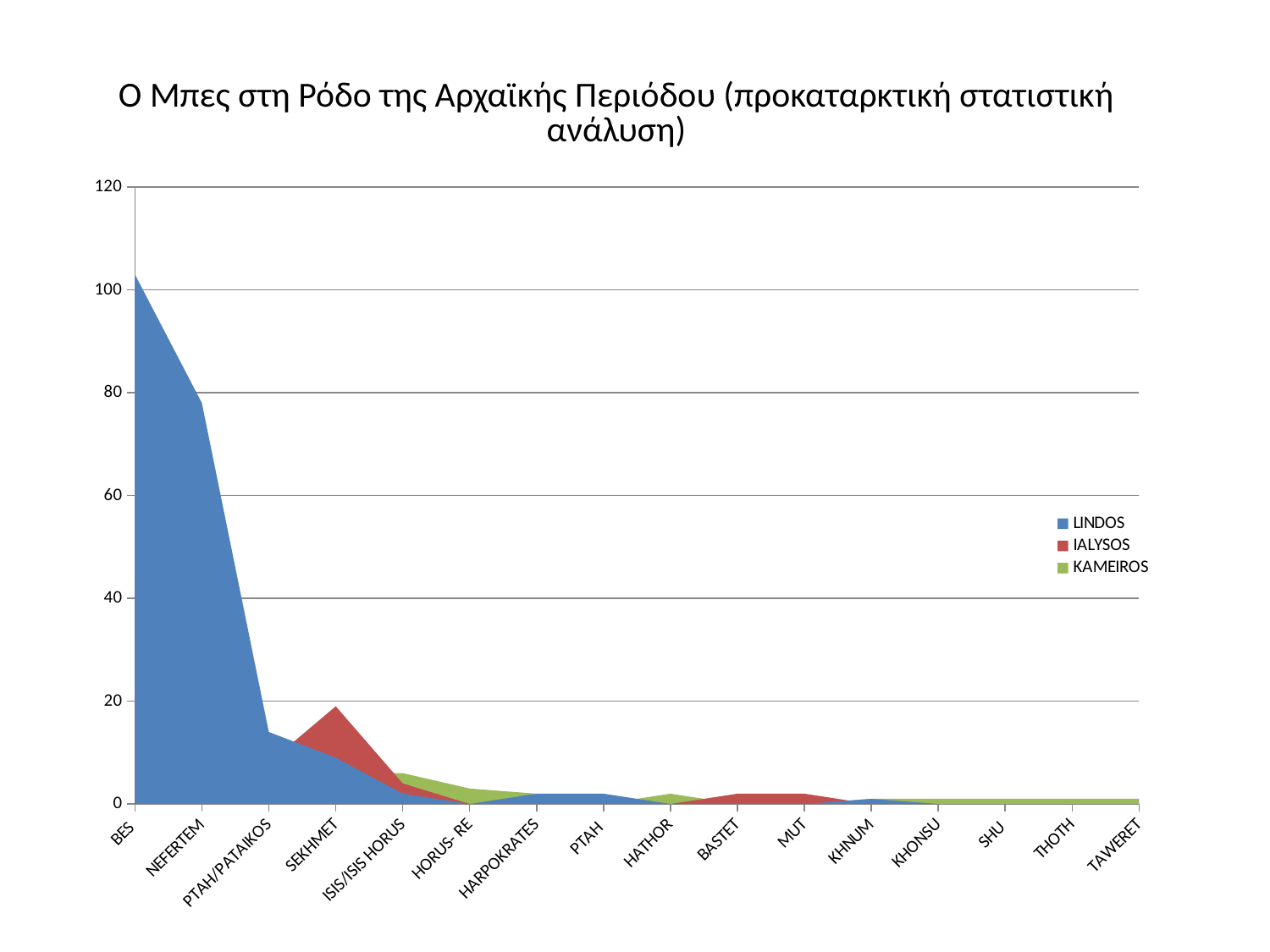
Is the LINDOS value for HARPOKRATES greater or less than 20? less Do the LINDOS values rise or fall from BES to PTAH/PATAIKOS? fall Is the LINDOS value for PTAH/PATAIKOS greater or less than 20? less Which is larger, the LINDOS value for BES or the LINDOS value for NEFERTEM? BES Which category has the highest value for LINDOS? BES How many categories are shown along the x axis? 16 Is the LINDOS value for NEFERTEM greater or less than 60? greater Which series is shown in red? IALYSOS Which series is shown in green? KAMEIROS How many series does the legend list? 3 What kind of chart is shown on the slide? area chart